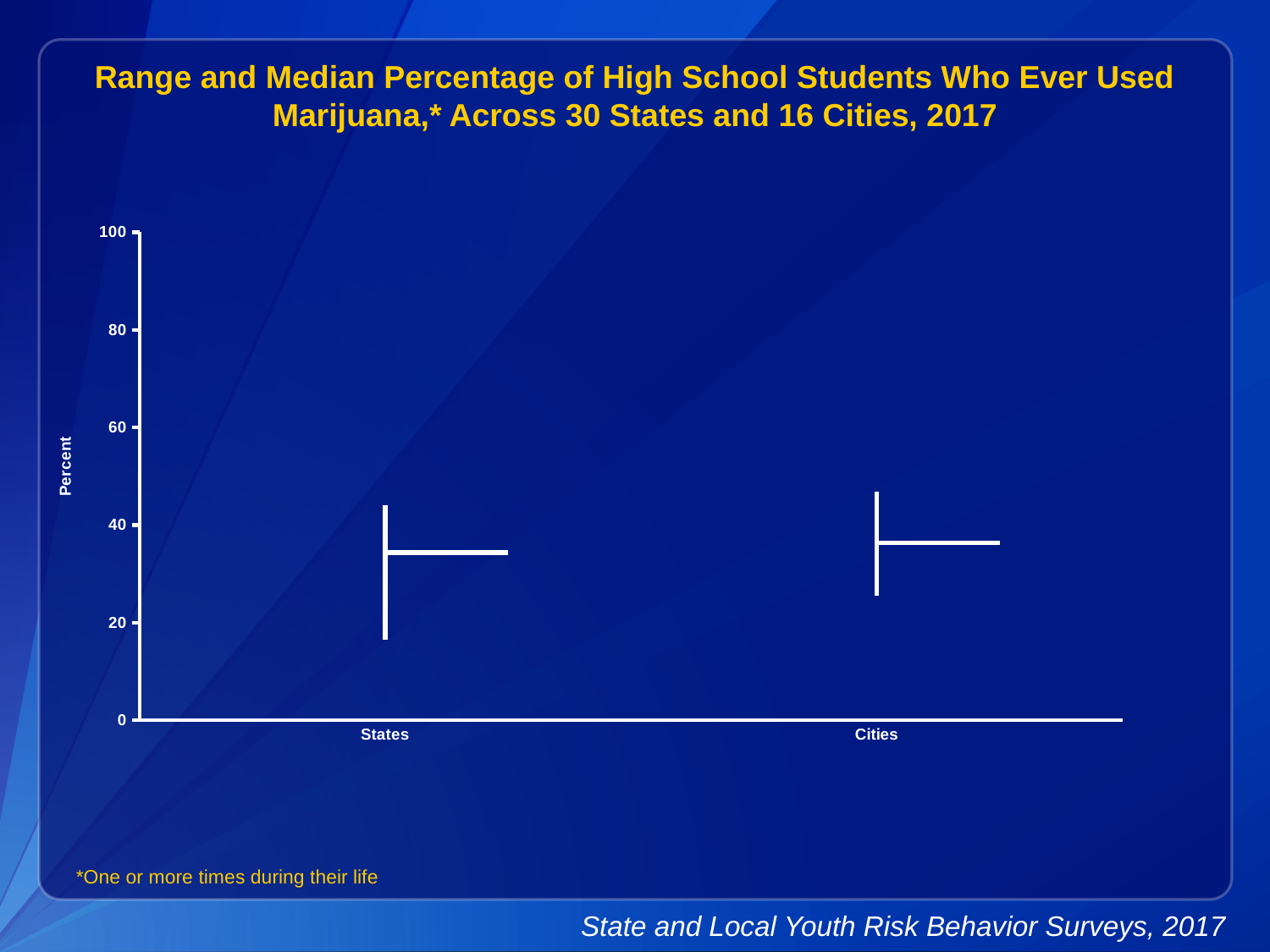
Which category has the lower bottom of its range, States or Cities? States Is the median value for Cities greater or less than 40? less What are the two categories shown on the x axis? States and Cities Is the highest value of the range for States greater or less than 40? greater Is the lowest value of the range for Cities greater or less than 20? greater What is the label of the vertical axis? Percent What is the highest value shown on the vertical axis? 100 How many categories are shown on the x axis of the chart? 2